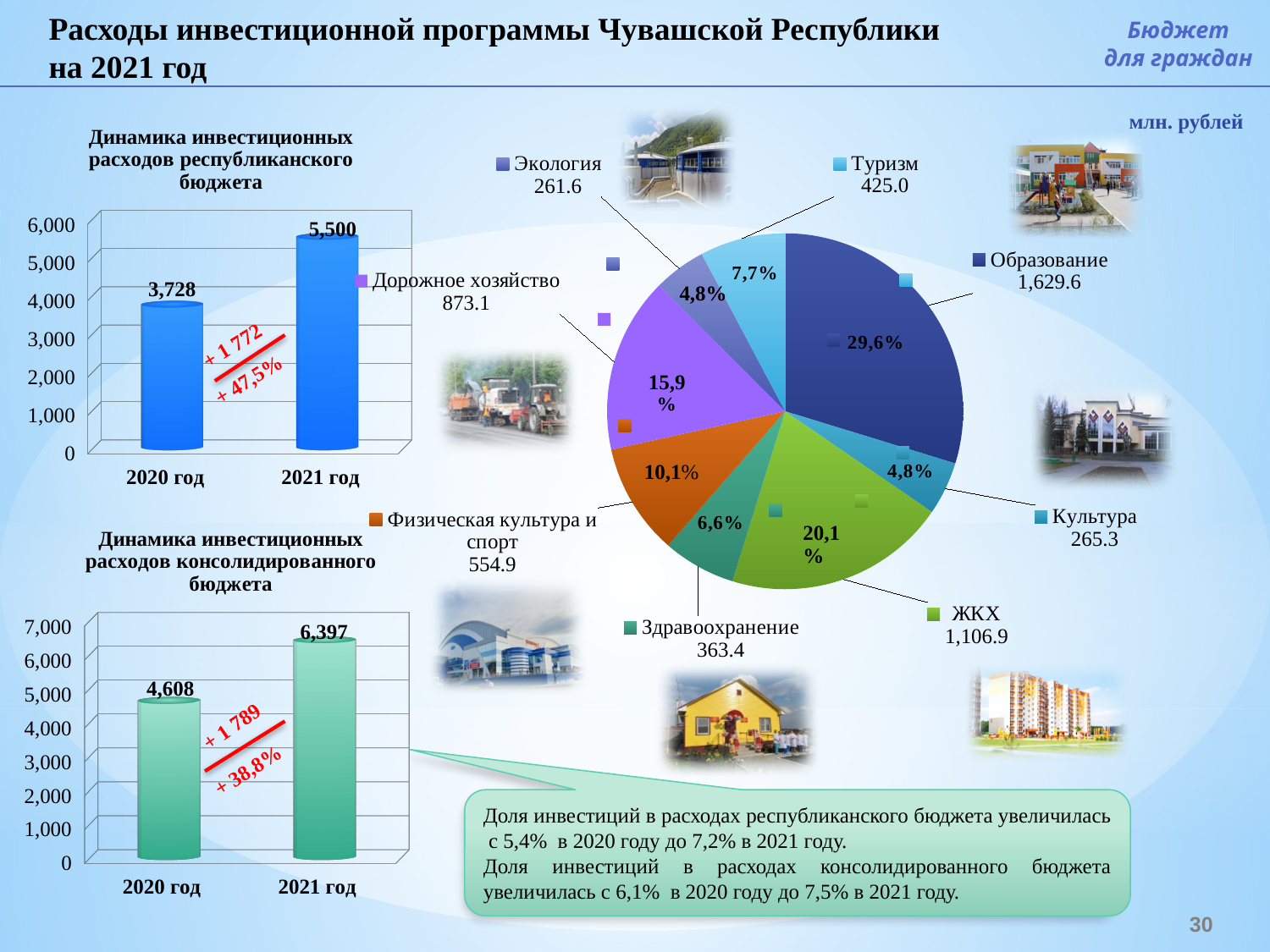
In the chart 'Динамика инвестиционных расходов консолидированного бюджета', what is the value for 2021 год? 6,397 In the pie chart in the centre of the slide, how many categories are shown? 8 In the chart 'Динамика инвестиционных расходов республиканского бюджета', do the values rise or fall from 2020 год to 2021 год? rise In the pie chart in the centre of the slide, which category has the largest value? Образование In the chart 'Динамика инвестиционных расходов республиканского бюджета', what is the value for 2021 год? 5,500 In the chart 'Динамика инвестиционных расходов консолидированного бюджета', what is the difference between the 2021 год and 2020 год values? 1,789 In the pie chart in the centre of the slide, what is the value for Образование? 1,629.6 In the chart 'Динамика инвестиционных расходов республиканского бюджета', what is the value for 2020 год? 3,728 In the pie chart in the centre of the slide, what share does ЖКХ have? 20,1% In the pie chart in the centre of the slide, which category has the smallest value? Экология What kind of chart is 'Динамика инвестиционных расходов консолидированного бюджета'? bar chart In the pie chart in the centre of the slide, which is larger: Туризм or Здравоохранение? Туризм